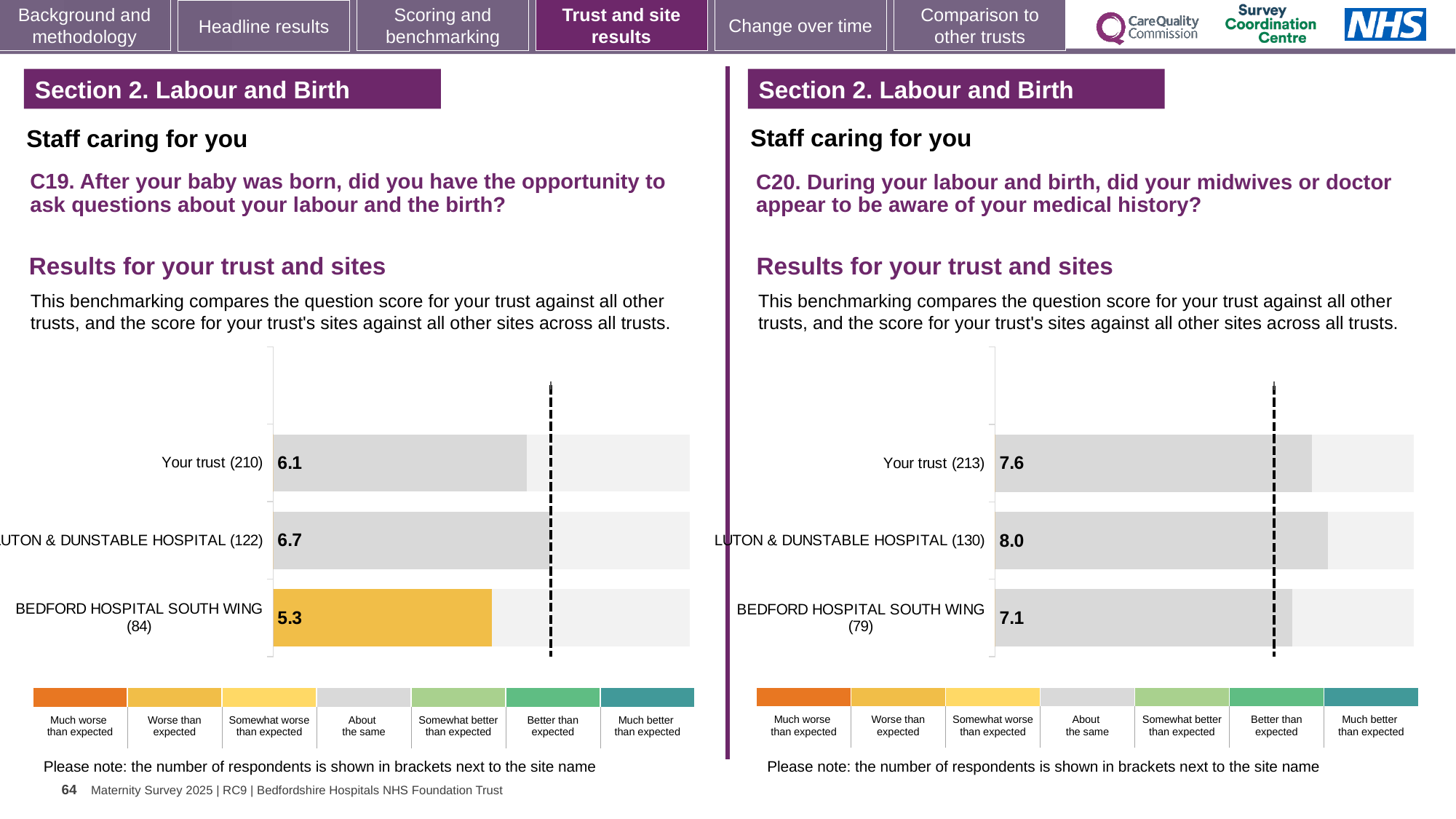
In the C20 chart on the right, what is the difference between the Your trust score and the Bedford Hospital South Wing score? 0.5 In the C19 chart on the left, how many respondents are shown in brackets for Your trust? 210 In the C19 chart on the left, what is the score for Your trust? 6.1 How many bars are plotted in the C19 chart on the left? 3 What type of chart is used for the C20 results on the right? Bar chart In the C19 chart on the left, what is the score for Bedford Hospital South Wing? 5.3 In the C19 chart on the left, which site or trust has the highest score? Luton & Dunstable Hospital In the C19 chart on the left, what is the difference between the Luton & Dunstable Hospital score and the Bedford Hospital South Wing score? 1.4 Is the Bedford Hospital South Wing score higher in the C19 chart on the left or the C20 chart on the right? C20 chart on the right In the C20 chart on the right, what is the score for Your trust? 7.6 In the C20 chart on the right, what is the score for Luton & Dunstable Hospital? 8.0 In the C20 chart on the right, which site or trust has the lowest score? Bedford Hospital South Wing